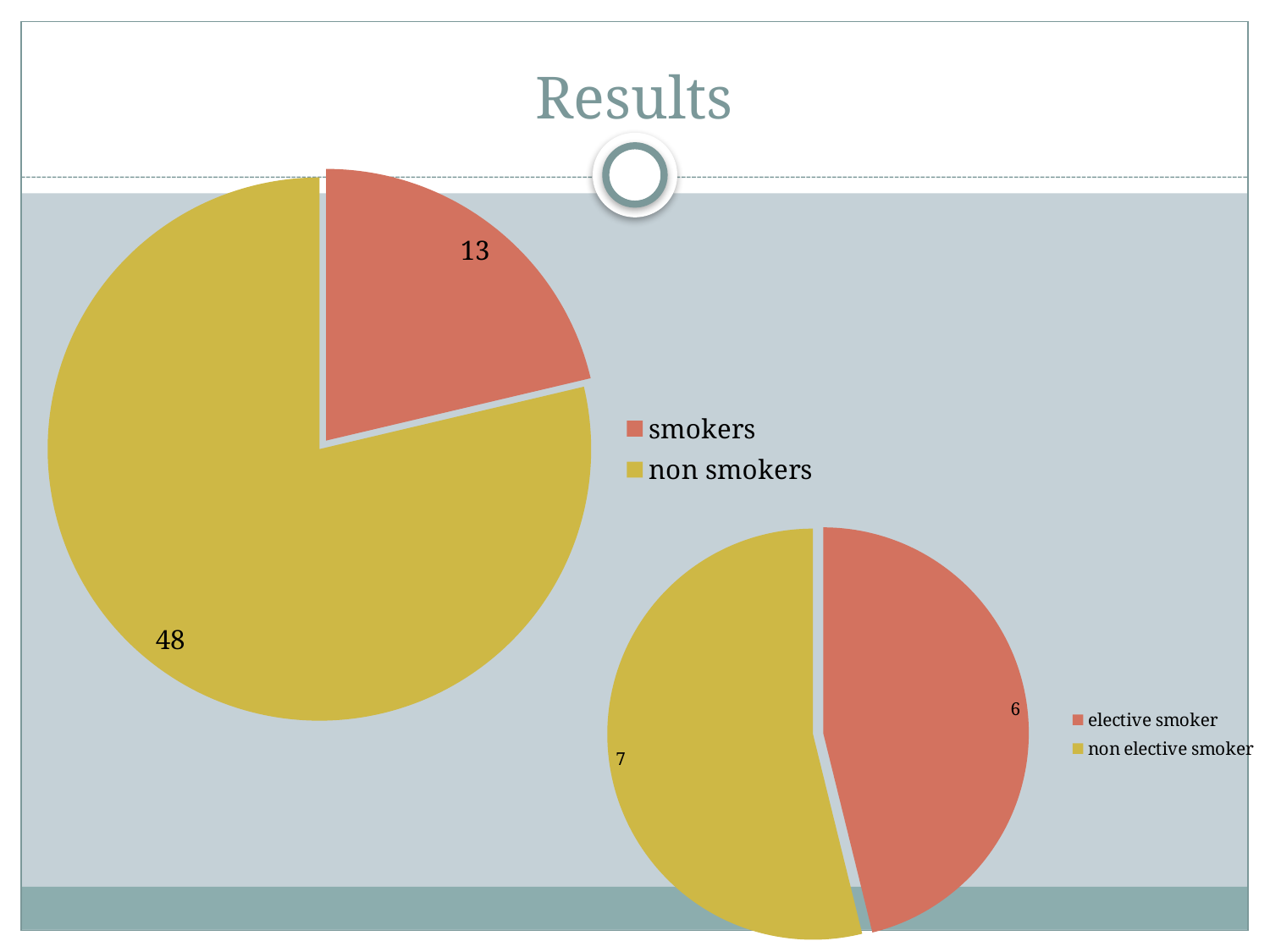
In the smaller pie chart on the lower right, what is the value for elective smoker? 6 In the smaller pie chart on the lower right, what is the value for non elective smoker? 7 In the larger pie chart on the left, what is the difference between the non smokers value and the smokers value? 35 In the larger pie chart on the left, what is the value for non smokers? 48 In the smaller pie chart on the lower right, which category has the smallest slice? elective smoker In the larger pie chart on the left, what is the value for smokers? 13 In the smaller pie chart on the lower right, what is the difference between the non elective smoker value and the elective smoker value? 1 In the larger pie chart on the left, what colour is the smokers slice? red In the larger pie chart on the left, what is the total of the two slices? 61 What type of chart is the larger chart on the left? pie chart How many categories does the legend of the smaller pie chart on the lower right list? 2 In the larger pie chart on the left, which category has the largest slice? non smokers